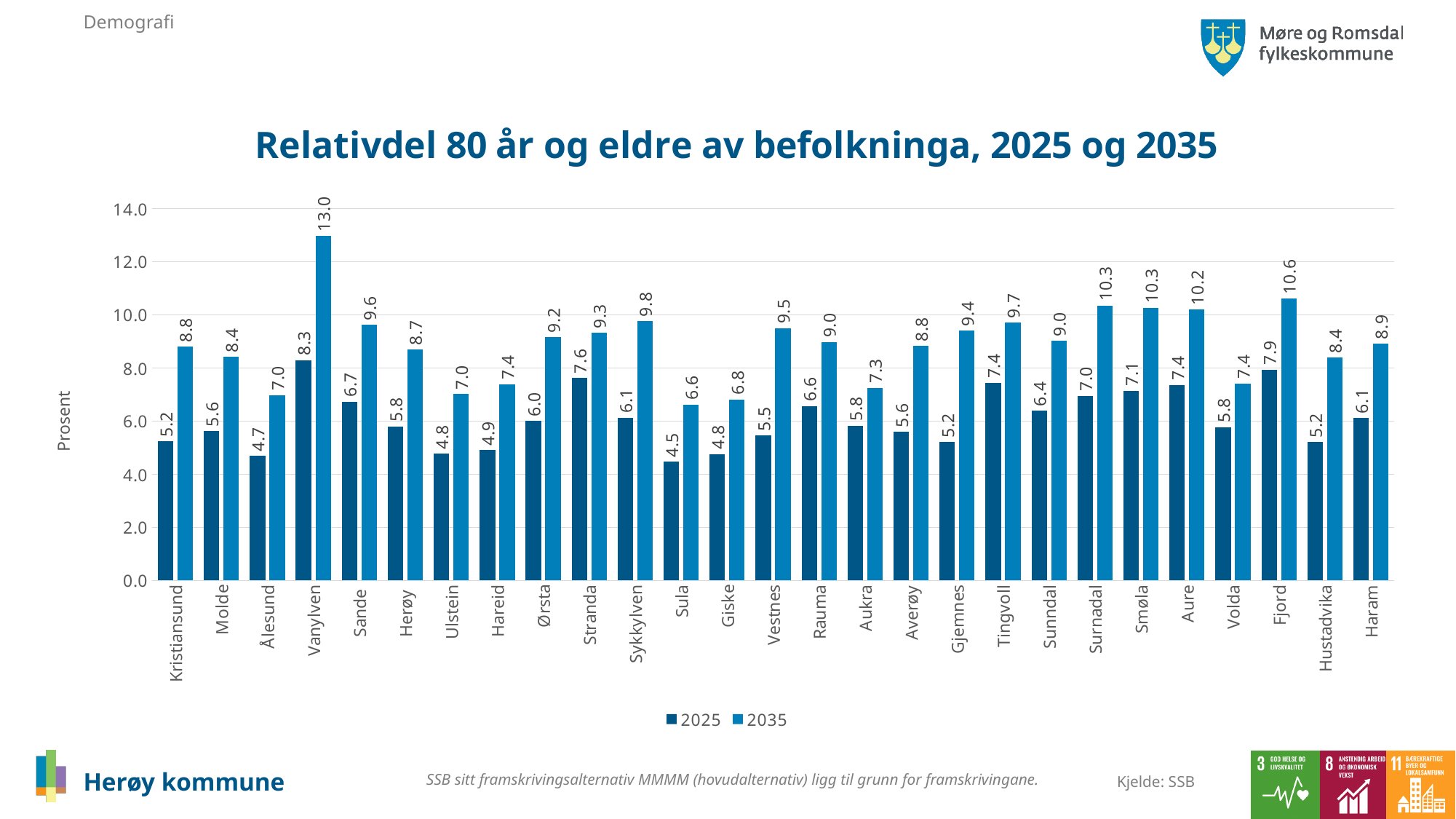
Which municipality has the lowest 2025 value? Sula What is the 2025 value for Herøy? 5.8 What is the title of the chart? Relativdel 80 år og eldre av befolkninga, 2025 og 2035 How many series does the legend list? 2 What is the 2035 value for Fjord? 10.6 Which is larger, the 2025 value for Stranda or the 2025 value for Molde? Stranda Is the 2035 value for Surnadal greater or less than 10.0? greater How many municipalities are shown on the x axis? 27 Which municipality has the highest 2035 value? Vanylven What kind of chart is shown on the slide? Bar chart What is the difference between the 2035 and 2025 values for Herøy? 2.9 What is the 2035 value for Vanylven? 13.0